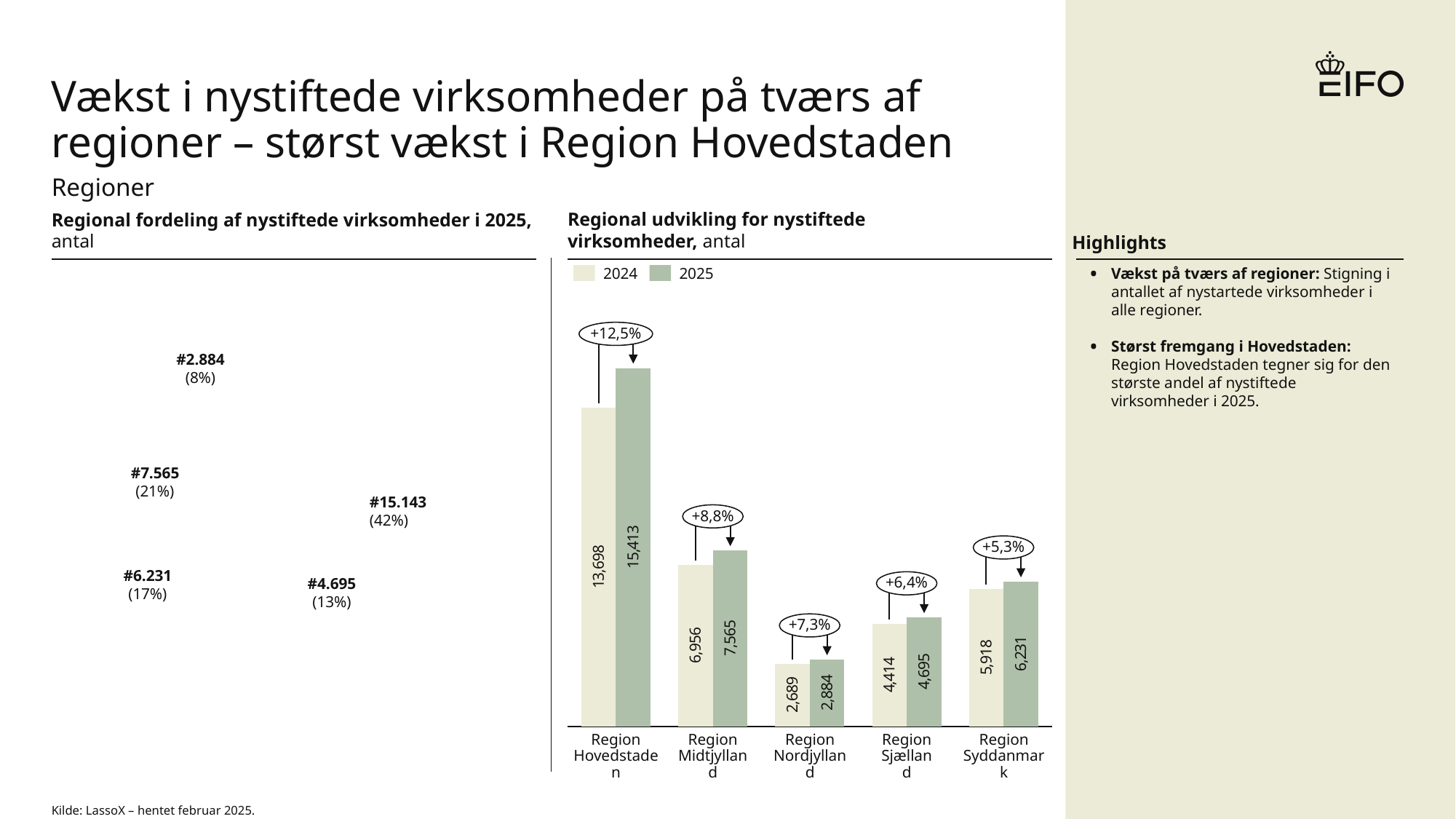
In the chart 'Regional udvikling for nystiftede virksomheder', what is the 2024 value for Region Midtjylland? 6,956 In the chart 'Regional udvikling for nystiftede virksomheder', which is larger: the 2025 value for Region Sjælland or the 2024 value for Region Syddanmark? 2024 value for Region Syddanmark In the chart 'Regional udvikling for nystiftede virksomheder', what is the difference between the 2025 and 2024 values for Region Syddanmark? 313 In the chart 'Regional udvikling for nystiftede virksomheder', which region shows the largest percentage growth? Region Hovedstaden In the chart 'Regional udvikling for nystiftede virksomheder', which region has the highest 2025 value? Region Hovedstaden What kind of chart is 'Regional udvikling for nystiftede virksomheder'? Bar chart In the chart 'Regional udvikling for nystiftede virksomheder', what is the 2025 value for Region Nordjylland? 2,884 How many series does the legend of the chart 'Regional udvikling for nystiftede virksomheder' list? 2 In the chart 'Regional udvikling for nystiftede virksomheder', what percentage growth is shown for Region Sjælland? +6,4% In the chart 'Regional udvikling for nystiftede virksomheder', which region has the lowest 2024 value? Region Nordjylland How many regions are shown in the chart 'Regional udvikling for nystiftede virksomheder'? 5 In the chart 'Regional udvikling for nystiftede virksomheder', what is the 2025 value for Region Hovedstaden? 15,413